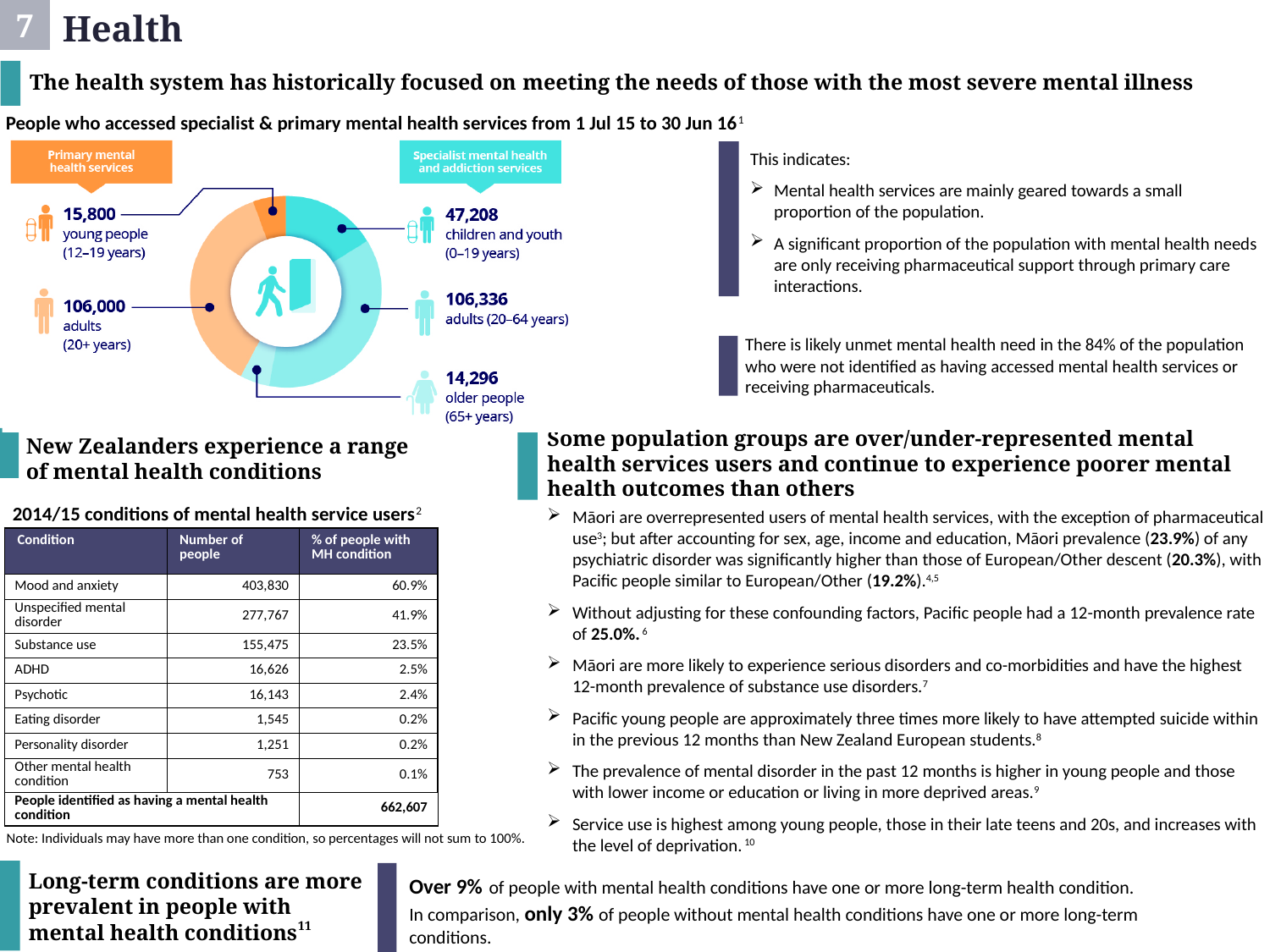
How many segments does the donut chart have? 5 In the donut chart, which group has the smallest number of people? Older people (65+ years): 14,296 What is the combined total of people who accessed specialist mental health and addiction services in the donut chart? 167,840 In the donut chart, how many adults (20+ years) accessed primary mental health services? 106,000 In the donut chart, how many older people (65+ years) accessed specialist mental health and addiction services? 14,296 In the donut chart, how many young people (12–19 years) accessed primary mental health services? 15,800 In the donut chart, which group has the largest number of people? Adults (20–64 years), specialist services: 106,336 In the donut chart, what is the difference between adults (20+ years) and young people (12–19 years) in primary mental health services? 90,200 In the donut chart, which is larger: children and youth (0–19 years) in specialist services or young people (12–19 years) in primary services? Children and youth (0–19 years) in specialist services In the donut chart, how many children and youth (0–19 years) accessed specialist mental health and addiction services? 47,208 In the donut chart, what is the difference between children and youth (0–19 years) in specialist services and older people (65+ years) in specialist services? 32,912 In the donut chart, which service type is shown in orange? Primary mental health services